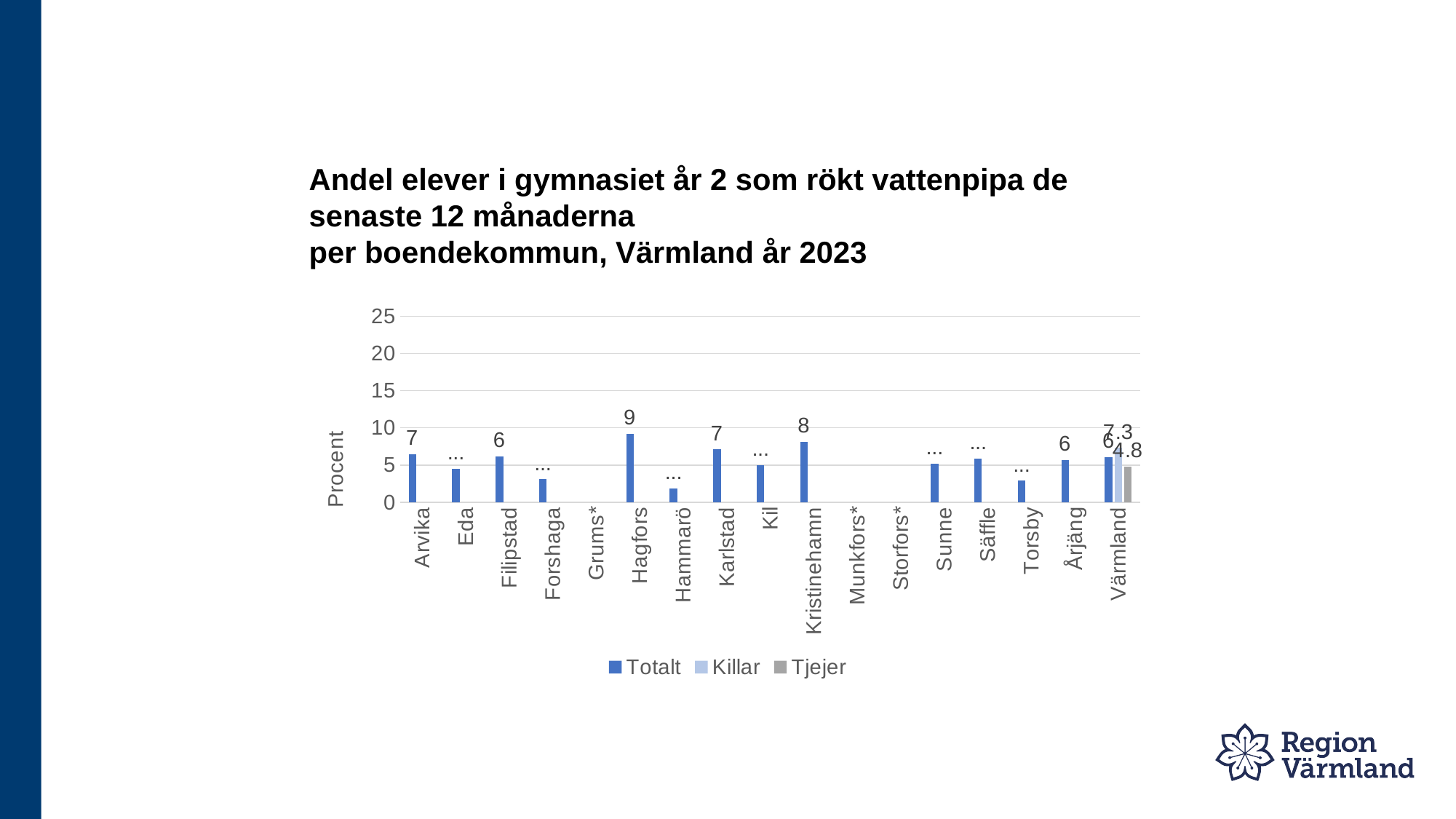
How many series does the legend list? 3 How many municipality categories are shown on the x axis? 17 What is the Killar value for Värmland? 7.3 What is the Tjejer value for Värmland? 4.8 What is the difference between the Totalt values for Hagfors and Kristinehamn? 1 Is the Totalt value for Hammarö greater or less than 5? less What kind of chart is shown on the slide? bar chart What is the Totalt value for Hagfors? 9 What is the difference between the Killar and Tjejer values for Värmland? 2.5 What is the Totalt value for Kristinehamn? 8 Which municipality has the highest Totalt value? Hagfors Which is larger, the Totalt value for Hagfors or for Arvika? Hagfors